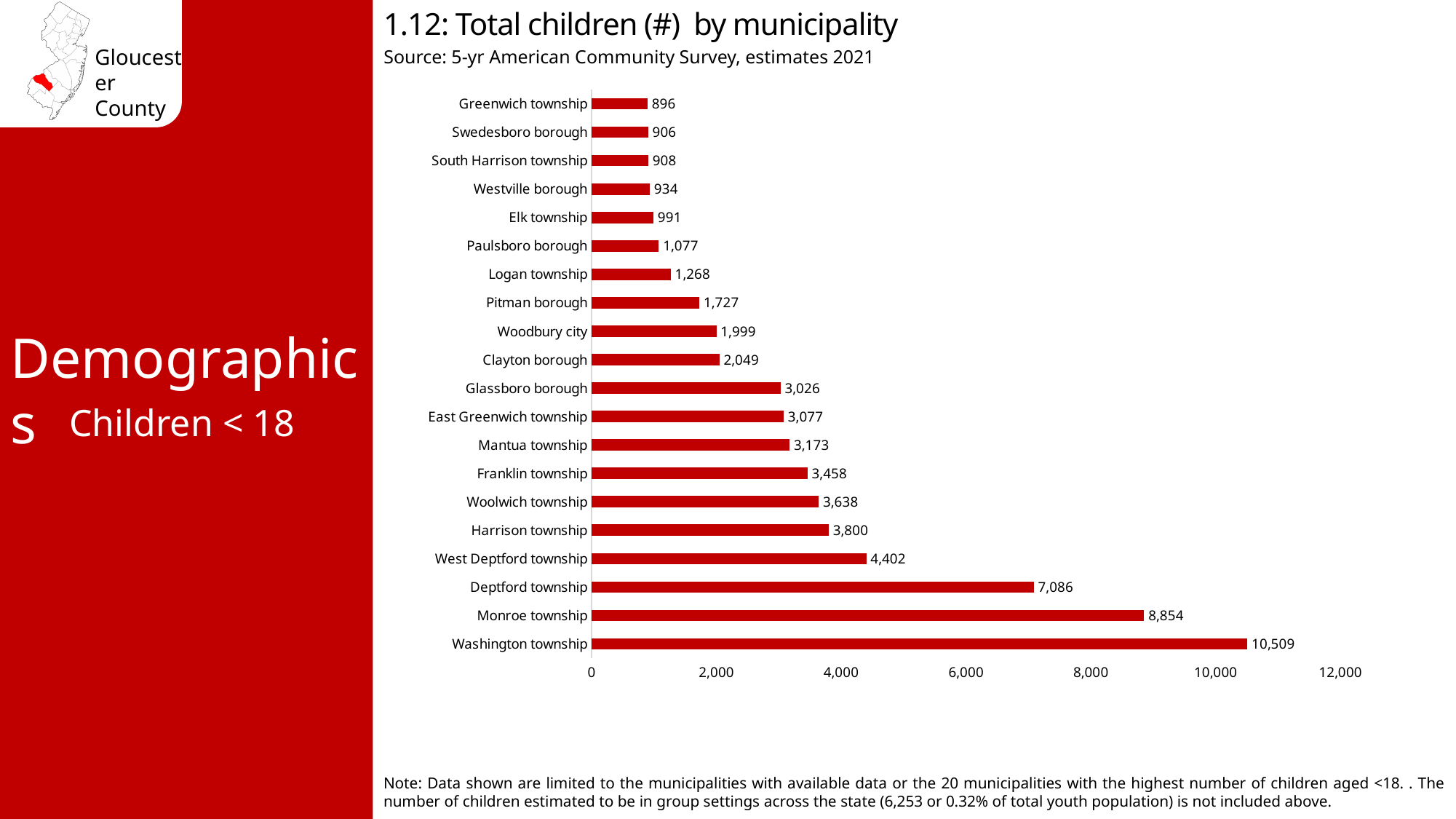
What is the total number of children in Pitman borough? 1,727 What kind of chart is shown on the slide? bar chart What is the total number of children in Woolwich township? 3,638 Which has more children, Harrison township or Franklin township? Harrison township What is the data source cited for the chart? 5-yr American Community Survey, estimates 2021 Is the value for Monroe township greater or less than 8,000? greater What is the difference in the number of children between Washington township and Monroe township? 1,655 What is the difference in the number of children between Deptford township and West Deptford township? 2,684 Which municipality has the lowest number of children? Greenwich township How many municipalities are shown in the chart? 20 Which municipality has the highest number of children? Washington township What is the total number of children in Washington township? 10,509